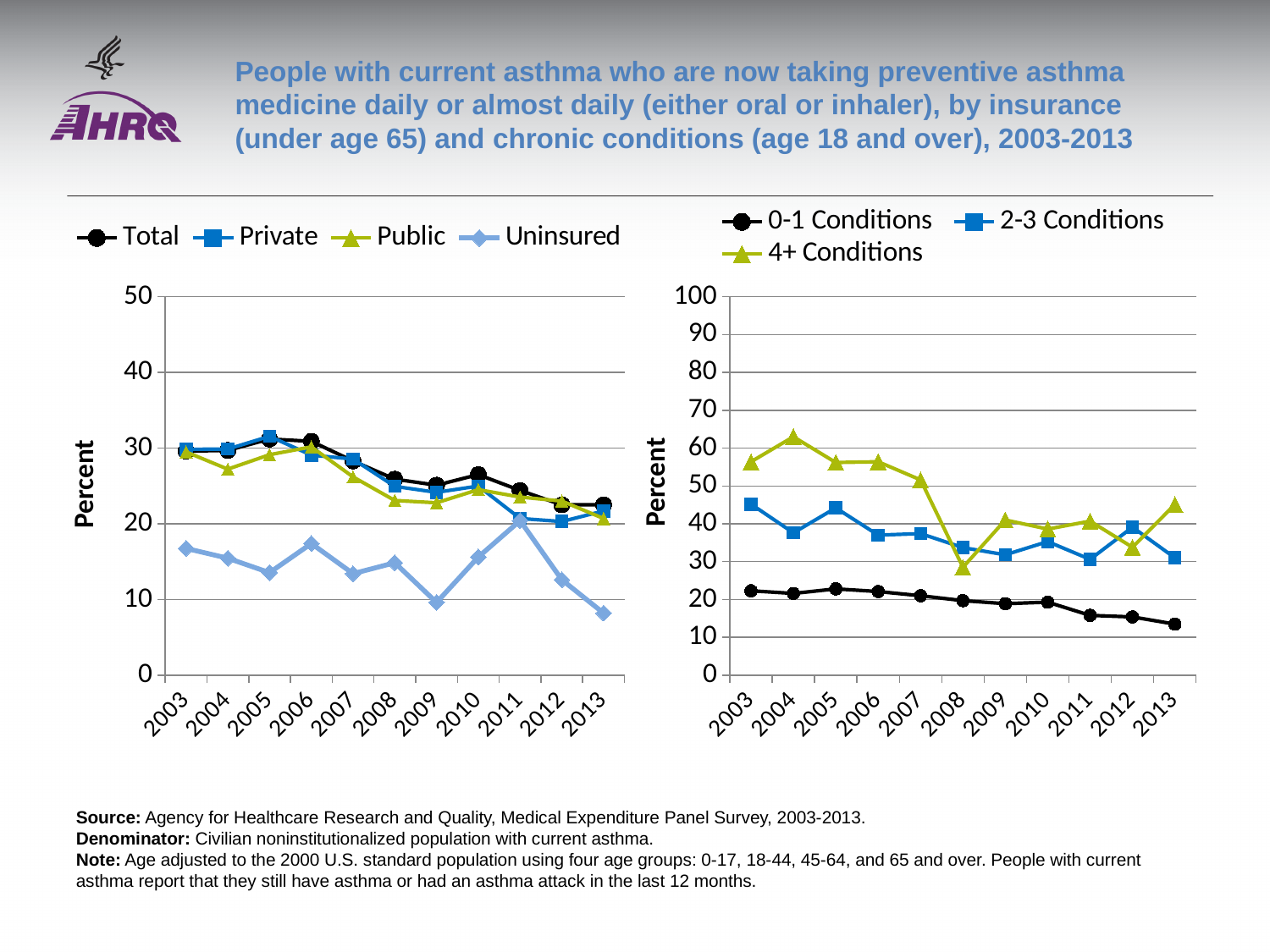
How many years are plotted along the x axis of the right chart? 11 How many series does the legend of the right chart list? 3 What is the label on the y axis of the left chart? Percent How many series does the legend of the left chart list? 4 In the right chart, does the 0-1 Conditions line rise or fall from 2003 to 2013? Fall In the right chart, is the value for 4+ Conditions in 2004 greater or less than 50? greater In the right chart, which series has the highest value in 2003? 4+ Conditions What kind of chart is the left chart (Total, Private, Public, Uninsured)? Line chart In the right chart, is the value for 0-1 Conditions in 2013 greater or less than 20? less In the left chart, which series has the lowest value in 2003? Uninsured In the left chart, is the value for Uninsured in 2003 greater or less than 20? less In the right chart, which is higher in 2008: 2-3 Conditions or 4+ Conditions? 2-3 Conditions